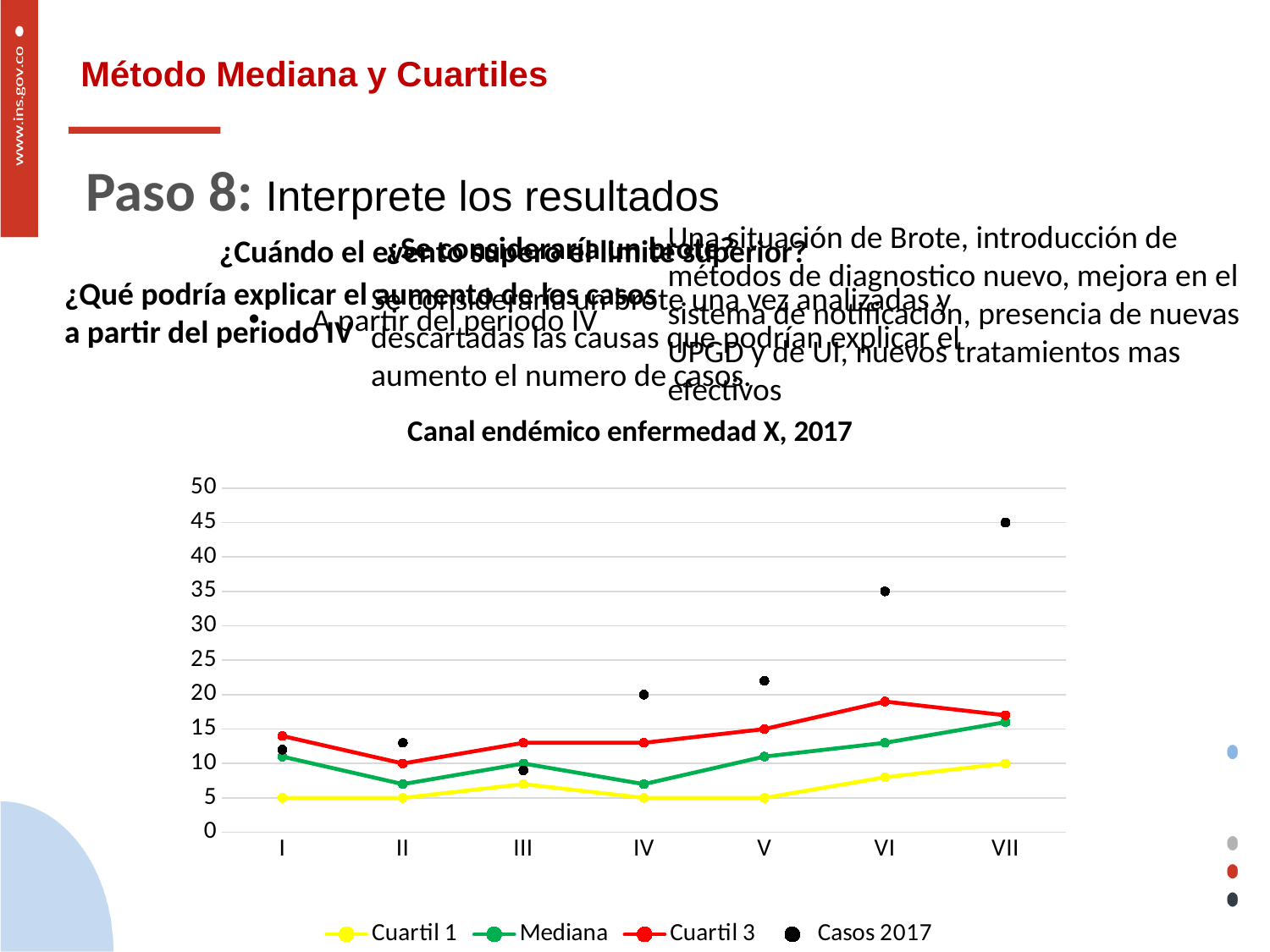
What is the title of the chart? Canal endémico enfermedad X, 2017 What is the value of Casos 2017 in period VI? 35 What kind of chart is shown on the slide? line chart What is the value of Casos 2017 in period VII? 45 Which is larger in period VII, Casos 2017 or Cuartil 3? Casos 2017 What is the value of Casos 2017 in period IV? 20 Is the value of Cuartil 3 in period VI greater or less than 15? greater In which period is Casos 2017 highest? VII Is the value of Casos 2017 in period V greater or less than 20? greater How many periods are shown on the x axis of the chart? 7 How many series does the chart legend list? 4 Does Casos 2017 rise or fall from period IV to period VII? rise